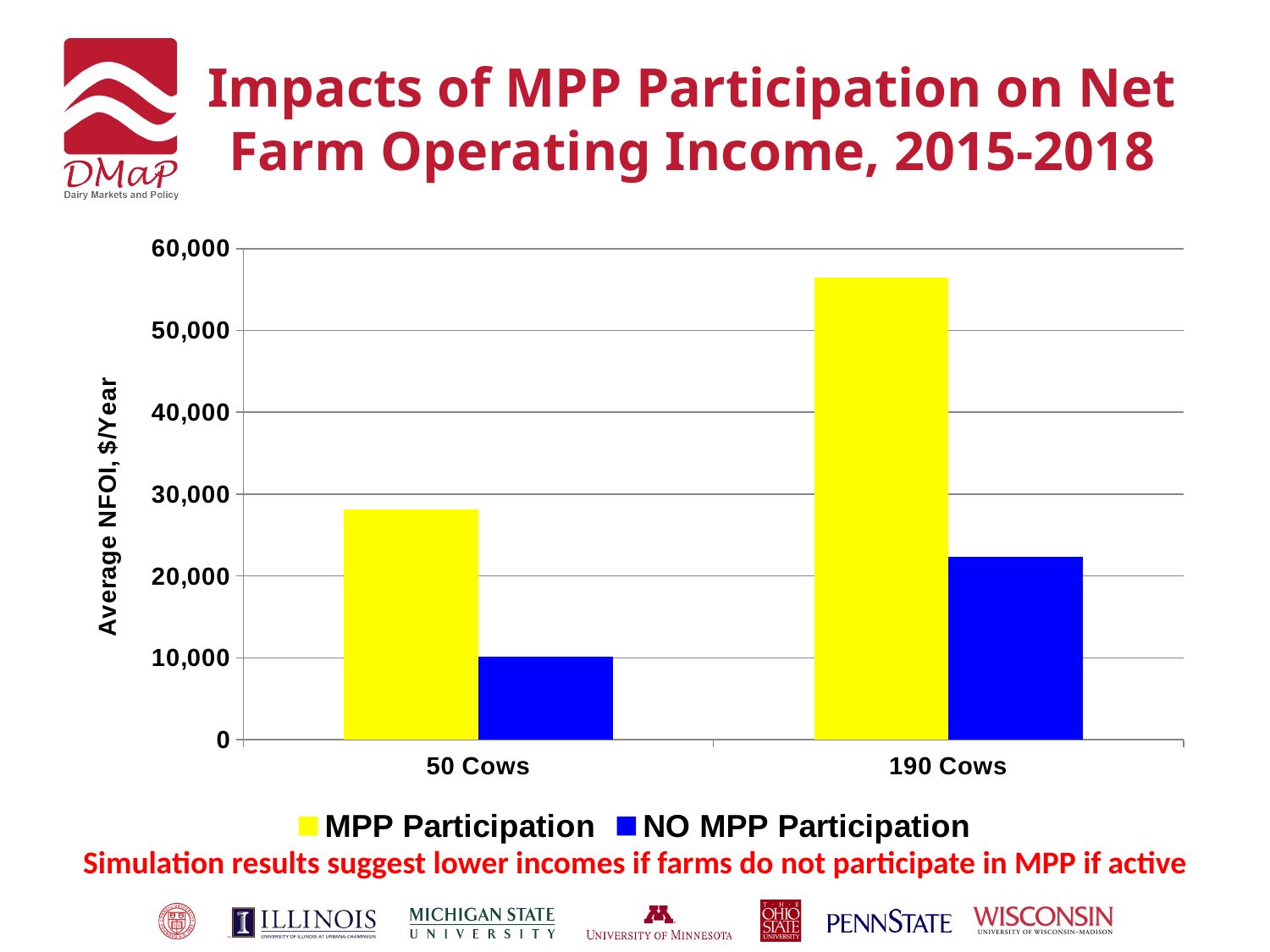
What kind of chart is shown on the slide? bar chart Which bar is the shortest in the chart? NO MPP Participation for 50 Cows For 50 Cows, which is larger: MPP Participation or NO MPP Participation? MPP Participation For 190 Cows, which is larger: MPP Participation or NO MPP Participation? MPP Participation Is the MPP Participation value for 190 Cows greater or less than 50,000? greater Is the MPP Participation value for 50 Cows greater or less than 30,000? less What is the label of the y axis? Average NFOI, $/Year Is the NO MPP Participation value for 190 Cows greater or less than 30,000? less How many herd-size categories are shown on the x axis? 2 Which bar is the tallest in the chart? MPP Participation for 190 Cows How many series does the legend list? 2